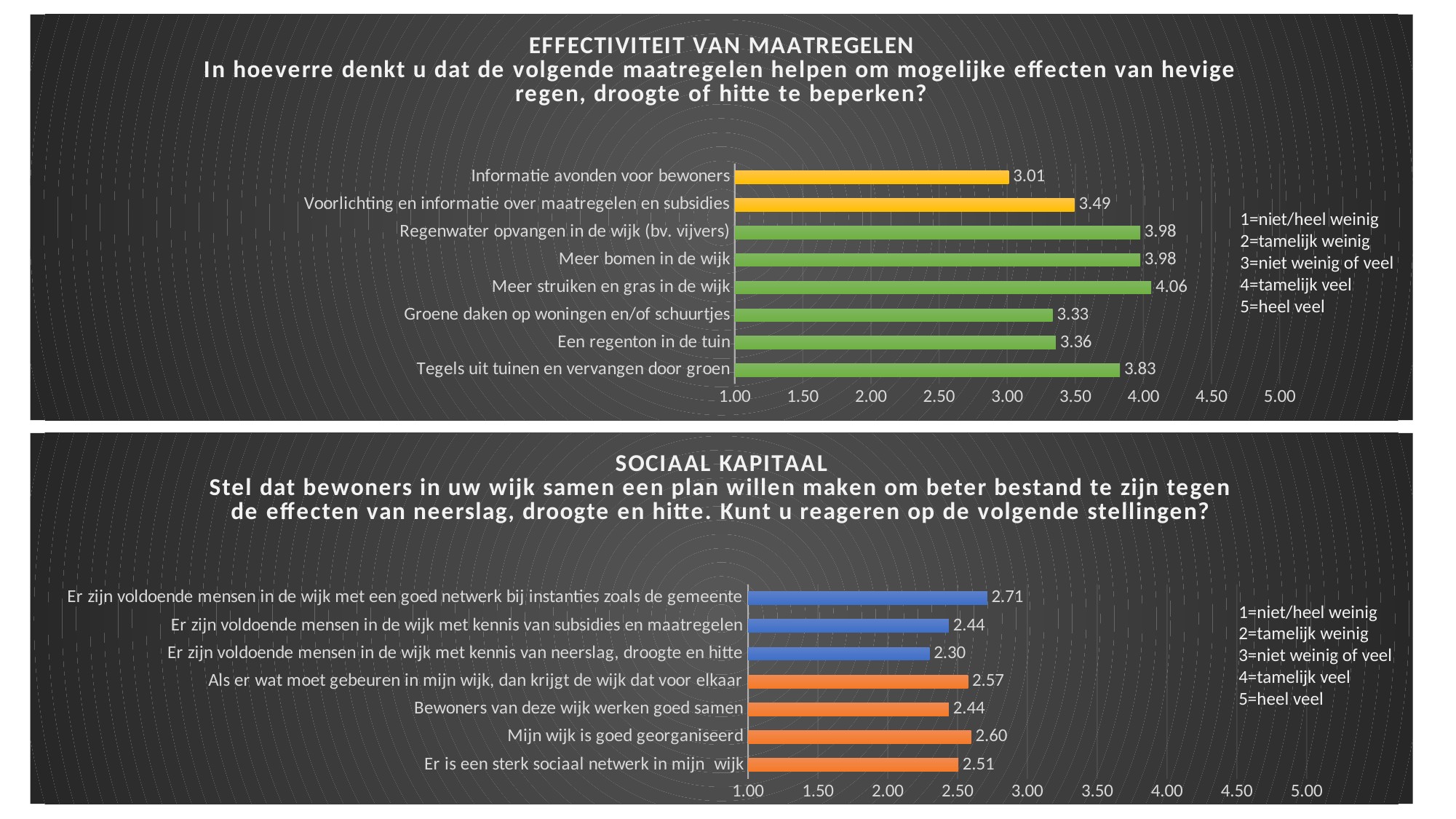
In the 'SOCIAAL KAPITAAL' chart, what is the difference between the highest value (2.71) and the lowest value (2.30)? 0.41 In the 'SOCIAAL KAPITAAL' chart, what is the value for 'Mijn wijk is goed georganiseerd'? 2.60 In the 'SOCIAAL KAPITAAL' chart, which statement has the lowest value? Er zijn voldoende mensen in de wijk met kennis van neerslag, droogte en hitte In the 'SOCIAAL KAPITAAL' chart, which statement has the highest value? Er zijn voldoende mensen in de wijk met een goed netwerk bij instanties zoals de gemeente In the 'EFFECTIVITEIT VAN MAATREGELEN' chart, how many measures are listed? 8 In the 'EFFECTIVITEIT VAN MAATREGELEN' chart, which measure has the lowest value? Informatie avonden voor bewoners In the 'EFFECTIVITEIT VAN MAATREGELEN' chart, which is larger: the value for 'Tegels uit tuinen en vervangen door groen' or for 'Voorlichting en informatie over maatregelen en subsidies'? Tegels uit tuinen en vervangen door groen In the 'EFFECTIVITEIT VAN MAATREGELEN' chart, which measure has the highest value? Meer struiken en gras in de wijk What type of chart is the 'SOCIAAL KAPITAAL' chart? Bar chart In the 'EFFECTIVITEIT VAN MAATREGELEN' chart, what is the value for 'Meer bomen in de wijk'? 3.98 In the 'EFFECTIVITEIT VAN MAATREGELEN' chart, what is the difference between the values for 'Meer struiken en gras in de wijk' and 'Informatie avonden voor bewoners'? 1.05 In the 'SOCIAAL KAPITAAL' chart, how many statements are listed? 7